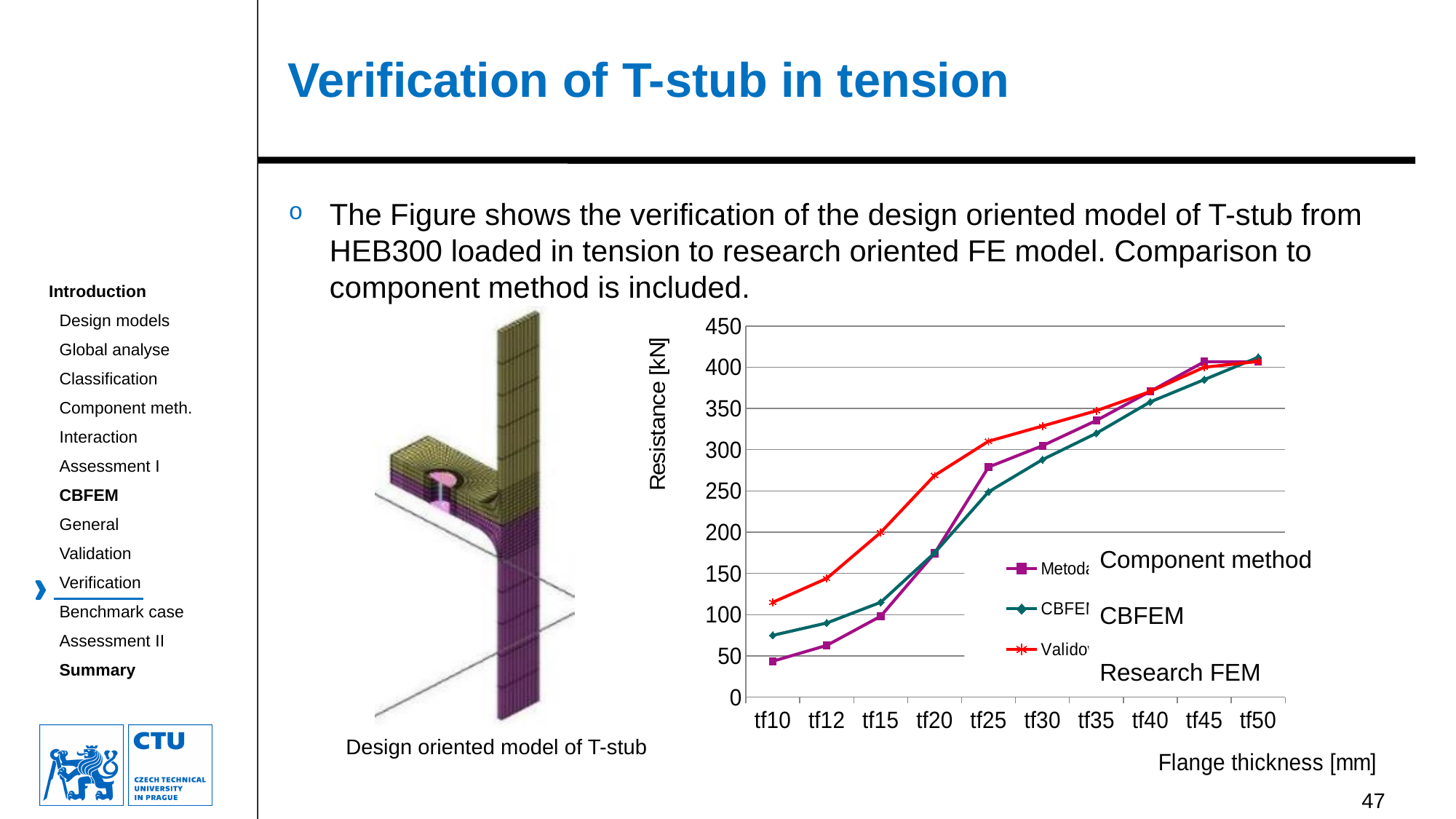
What kind of chart is shown on the slide? line chart What is the label of the horizontal axis of the chart? Flange thickness [mm] Is the Research FEM value at tf20 greater or less than 250? greater How many series does the chart plot? 3 How many flange thickness categories are shown on the x axis of the chart? 10 At tf10, which series has the larger value: Research FEM or Component method? Research FEM What is the label of the vertical axis of the chart? Resistance [kN] Is the Research FEM value at tf30 greater or less than 300? greater Is the Component method value at tf10 greater or less than 50? less Do the resistance values rise or fall as flange thickness increases from tf10 to tf50? rise Which series has the lowest value at tf10? Component method